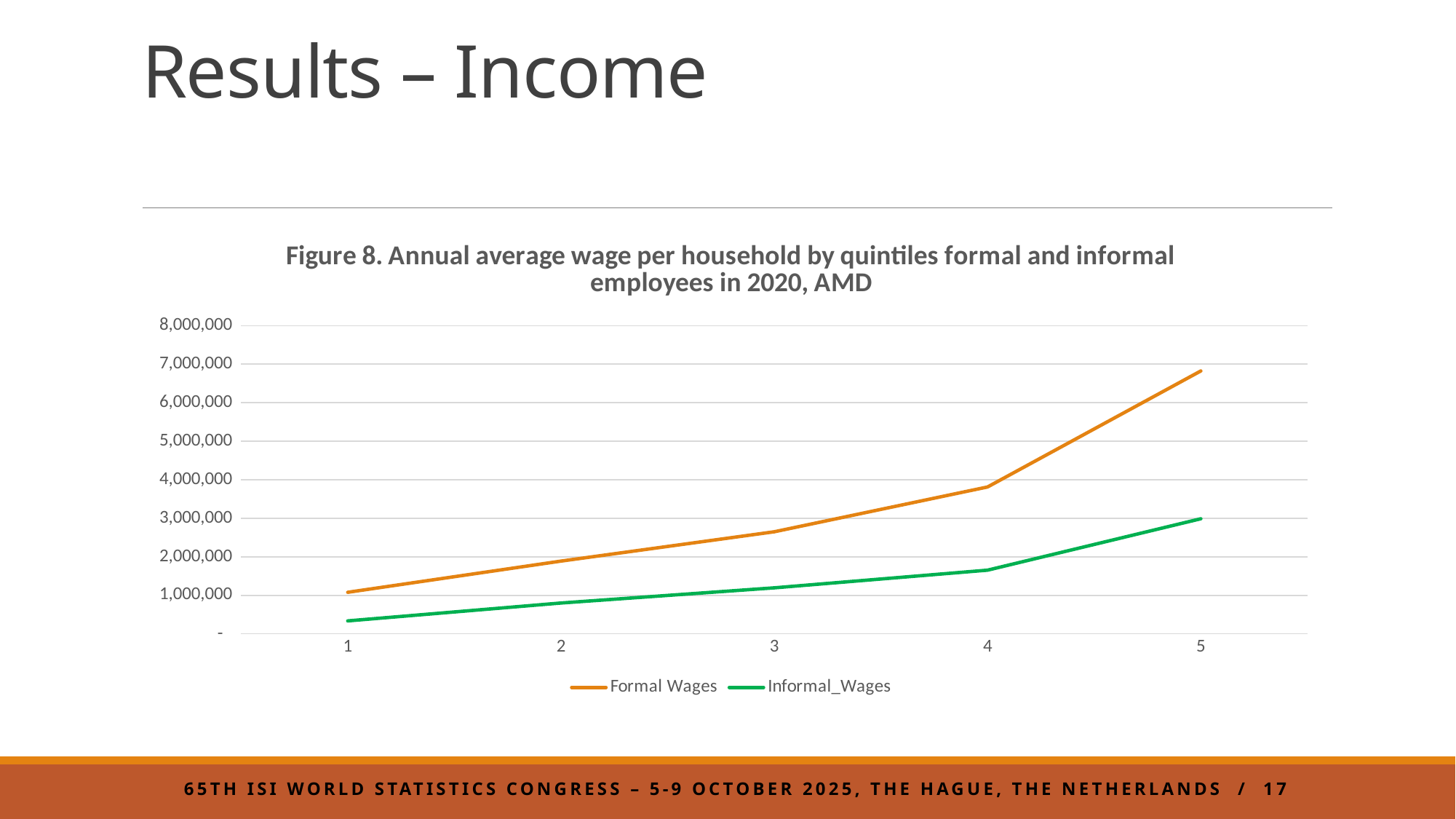
What colour is the Informal_Wages line? green How many series does the legend list? 2 Do Formal Wages rise or fall from quintile 1 to quintile 5? rise Which quintile has the lowest Informal_Wages value? 1 Which quintile has the highest Formal Wages value? 5 How many quintiles are plotted along the x axis? 5 Do Informal_Wages rise or fall from quintile 1 to quintile 5? rise Is the Formal Wages value for quintile 5 greater or less than 6,000,000? greater What kind of chart is shown on the slide? line chart Is the Informal_Wages value for quintile 1 greater or less than 1,000,000? less Is the Formal Wages value for quintile 4 greater or less than 3,000,000? greater At quintile 3, which series is larger, Formal Wages or Informal_Wages? Formal Wages